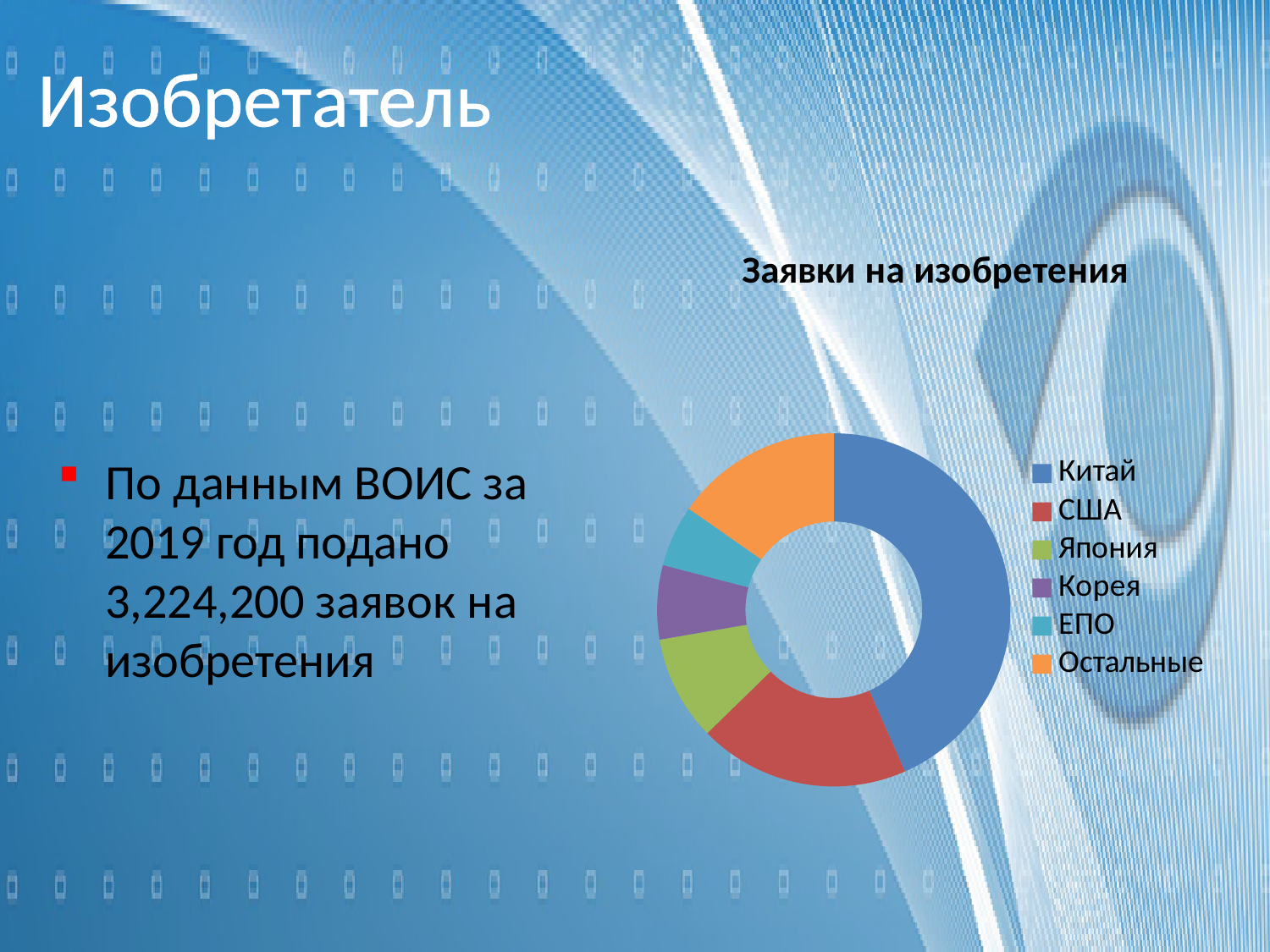
Which category is listed last in the legend? Остальные Which is larger, the share for США or the share for Япония? США How many categories does the chart show? 6 Which category is shown in blue on the chart? Китай Which category has the largest share of the chart? Китай What kind of chart is shown on the slide? doughnut chart What is the title of the chart? Заявки на изобретения Which is larger, the share for Остальные or the share for Корея? Остальные Which is larger, the share for Китай or the share for США? Китай